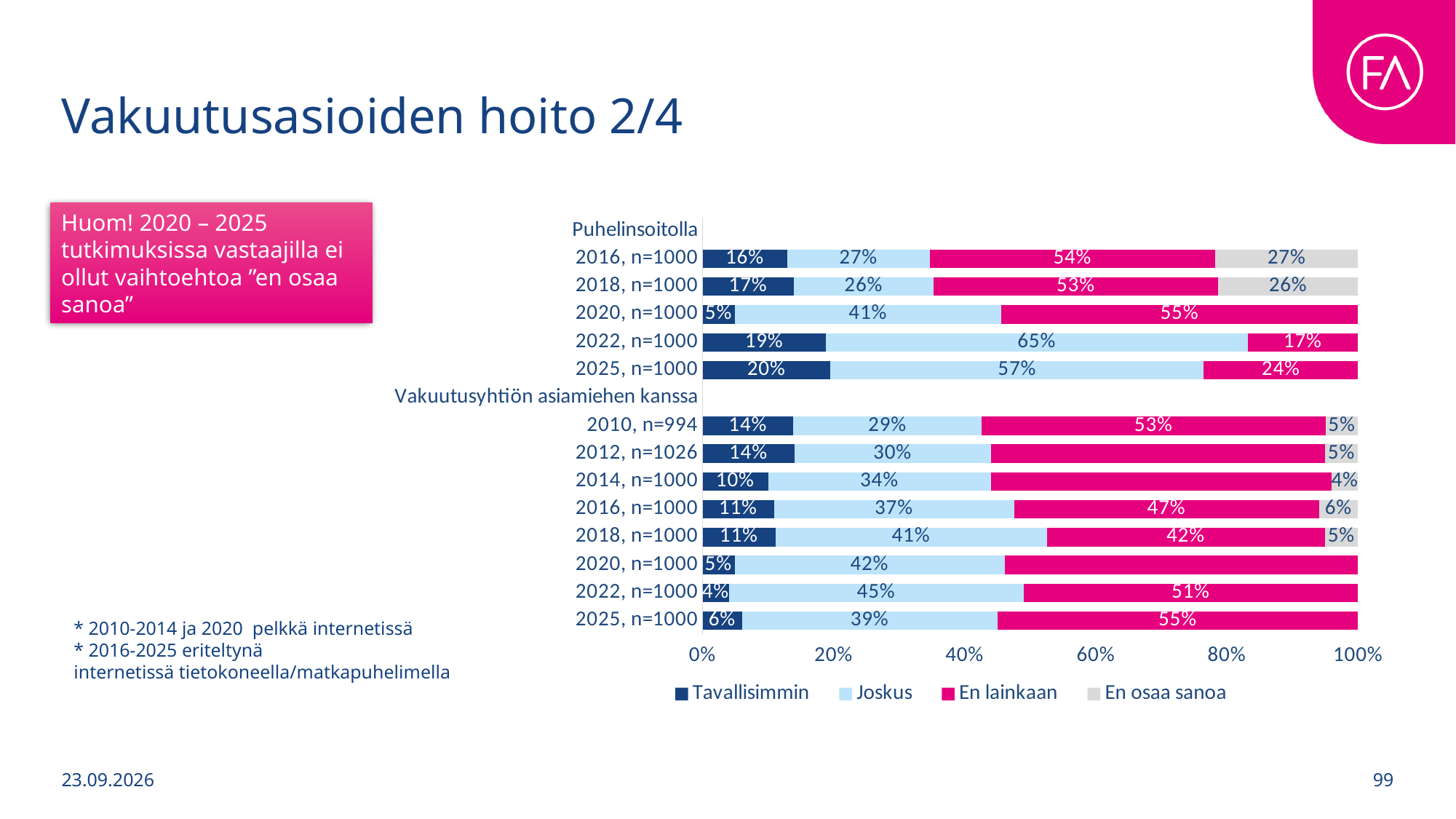
What is the "Tavallisimmin" value for Puhelinsoitolla in 2025, n=1000? 20% Does the "Tavallisimmin" share for Vakuutusyhtiön asiamiehen kanssa generally rise or fall from 2010 to 2025? Fall For Vakuutusyhtiön asiamiehen kanssa, which year has the larger "En lainkaan" share: 2016 or 2018? 2016 How many series does the legend list? 4 For Puhelinsoitolla in 2025, n=1000, how many percentage points larger is "Joskus" than "Tavallisimmin"? 37 percentage points For Vakuutusyhtiön asiamiehen kanssa in 2020, n=1000, is the "En lainkaan" value greater or less than 40%? greater How many bars are shown under the Puhelinsoitolla group? 5 Among the Puhelinsoitolla rows, which year has the highest "Joskus" share? 2022, n=1000 What kind of chart is shown on the slide? Stacked bar chart What percentage of respondents answered "Joskus" for Puhelinsoitolla in 2022, n=1000? 65% Among the Vakuutusyhtiön asiamiehen kanssa rows, which year has the lowest "Tavallisimmin" share? 2022, n=1000 What is the "En lainkaan" value for Vakuutusyhtiön asiamiehen kanssa in 2025, n=1000? 55%